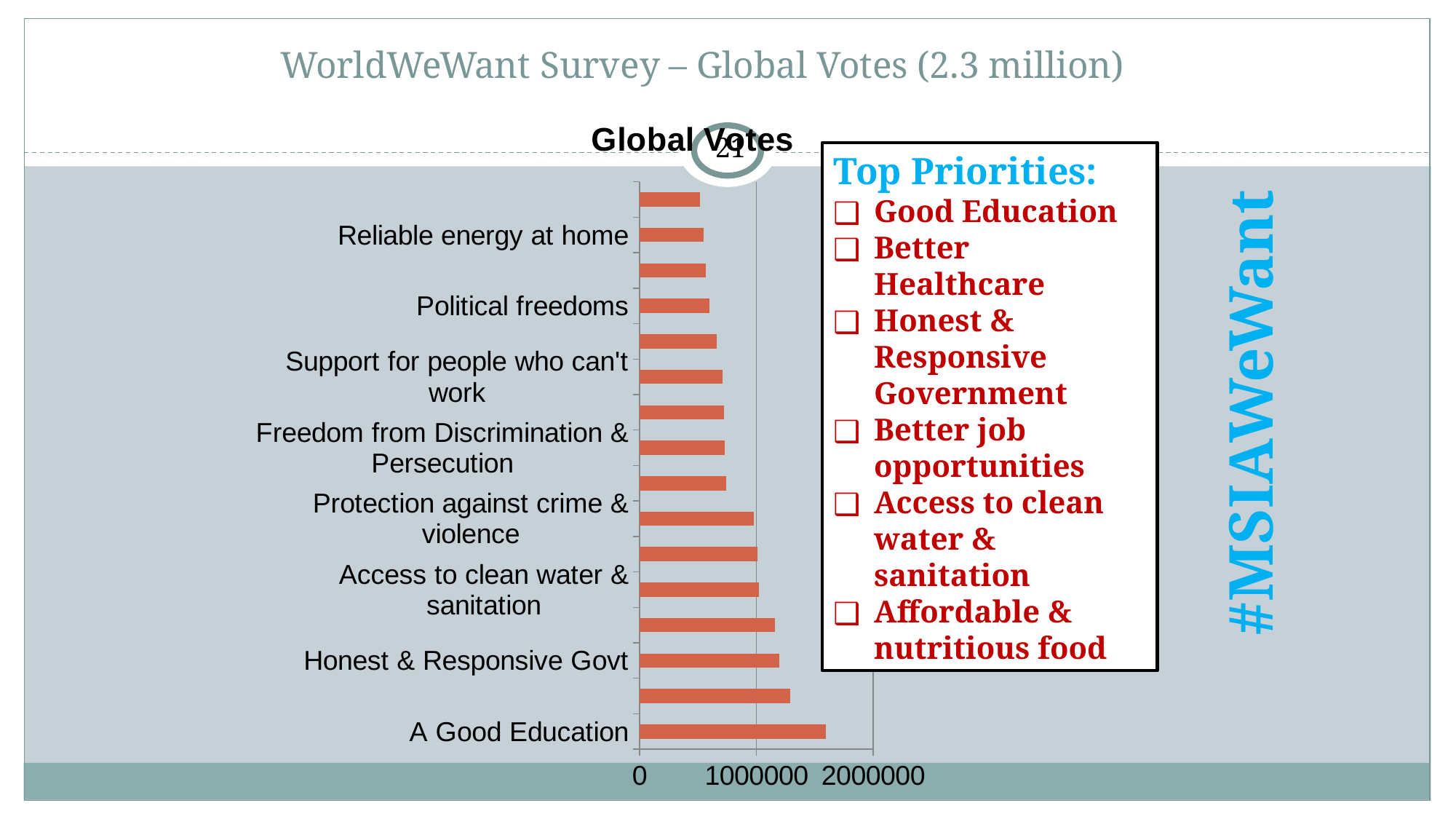
Which category has the highest number of global votes? A Good Education Is the value for Political freedoms greater or less than 1000000? less What is the title of the chart? Global Votes Is the value for Reliable energy at home greater or less than 1000000? less Is the value for Honest & Responsive Govt greater or less than 1000000? greater How many bars are plotted in the chart? 16 What kind of chart is shown on the slide? bar chart Which has more votes, Honest & Responsive Govt or Political freedoms? Honest & Responsive Govt Which has more votes, A Good Education or Reliable energy at home? A Good Education What colour are the bars in the chart? orange-red